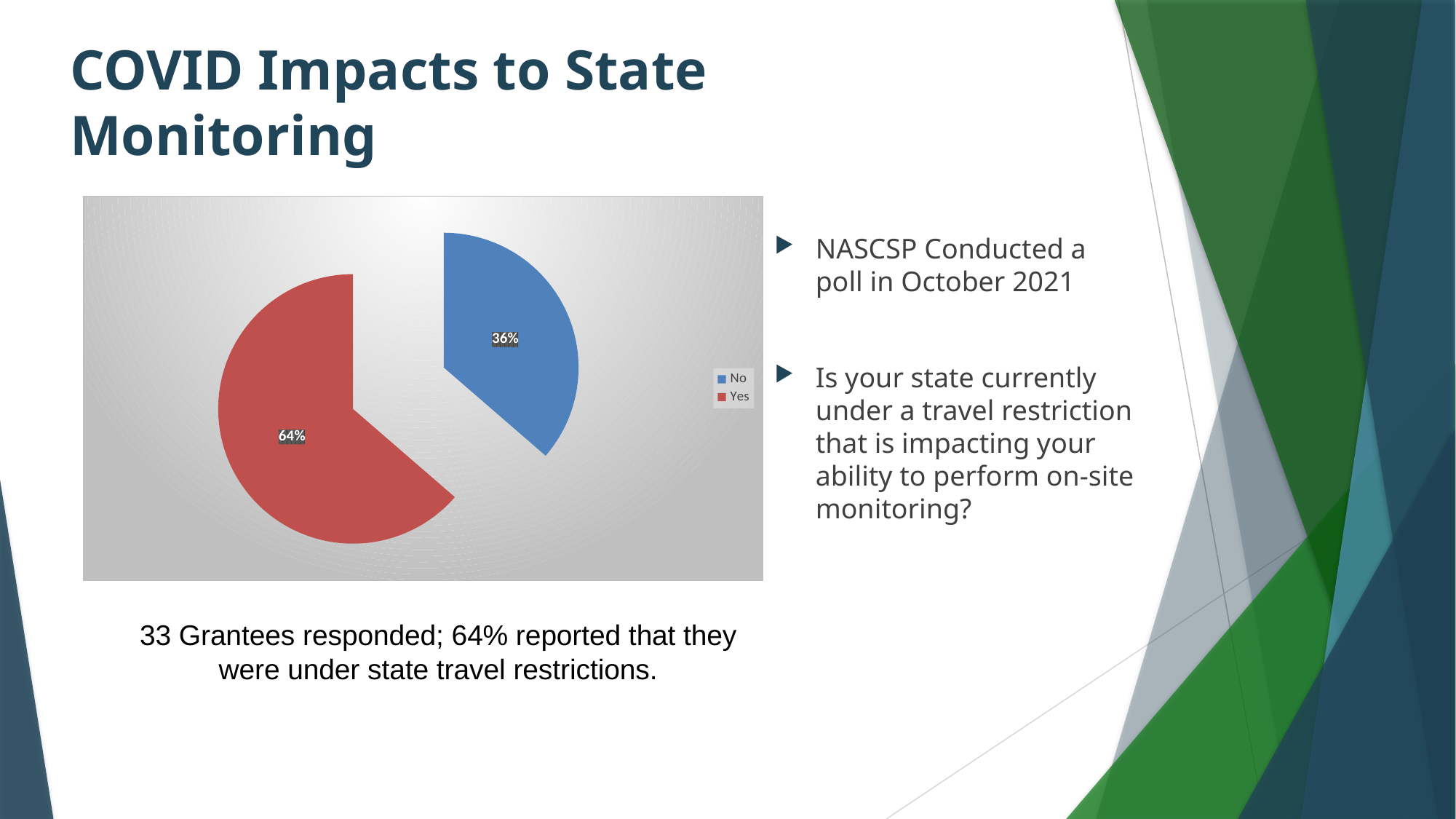
What colour is the "No" slice in the pie chart? blue What percentage of the pie is labelled for the "No" slice? 36% Which slice of the pie is the smallest? No What is the difference in percentage points between the "Yes" and "No" slices? 28 Which is larger, the "Yes" slice or the "No" slice? Yes How many entries does the legend list? 2 What percentage of the pie is labelled for the "Yes" slice? 64% How many slices does the pie chart have? 2 What colour is the "Yes" slice in the pie chart? red What share of the pie does the "Yes" slice represent? 64% What kind of chart is shown on the slide? pie chart Which slice of the pie is the largest? Yes